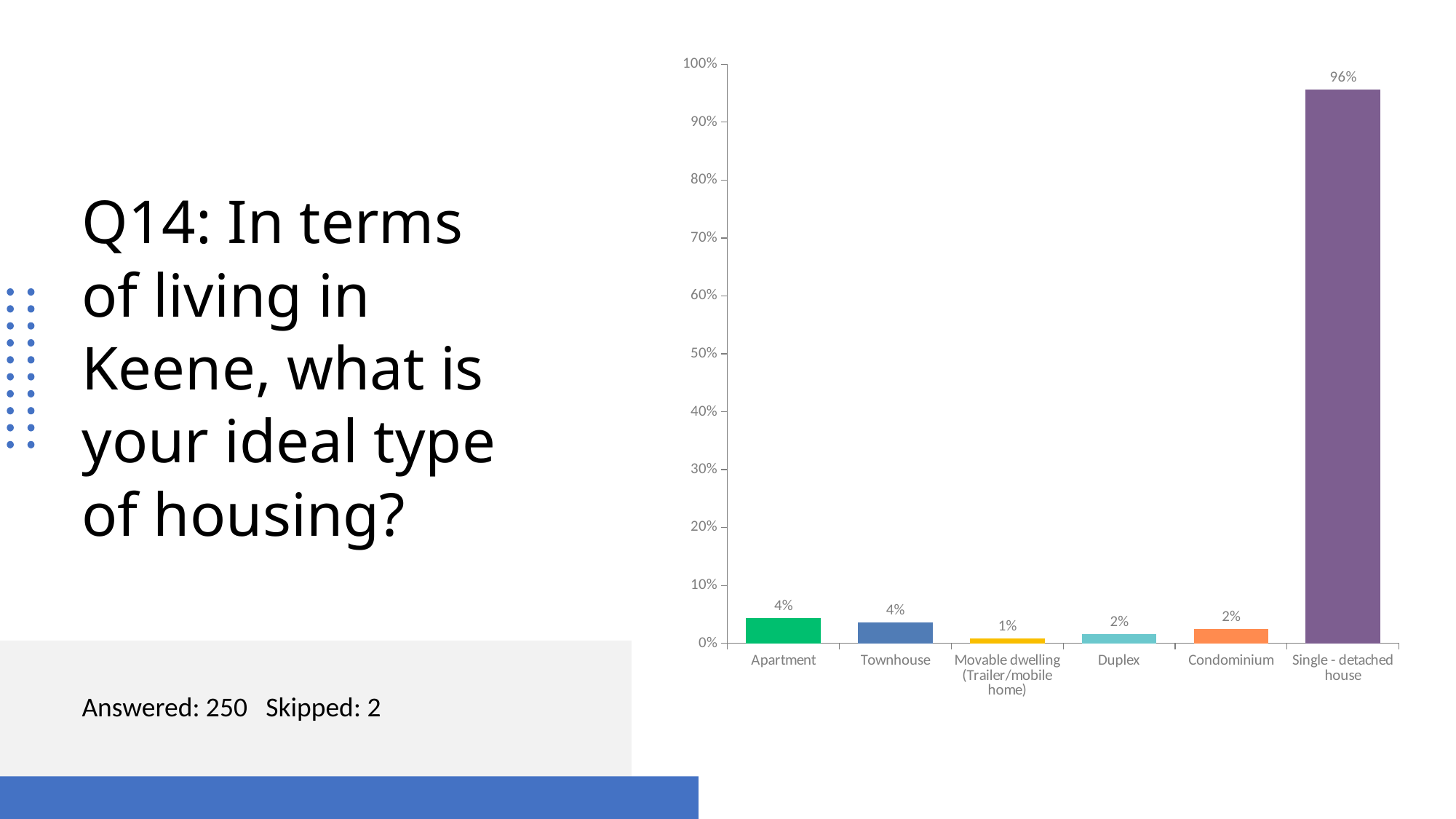
Which housing type has the lowest value in the chart? Movable dwelling (Trailer/mobile home) What is the value shown for Movable dwelling (Trailer/mobile home)? 1% Which housing type has the highest value in the chart? Single - detached house What colour is the bar for Single - detached house? Purple What is the difference between the values for Single - detached house and Townhouse? 92% Which is larger, the value for Duplex or the value for Single - detached house? Single - detached house What is the value shown for Apartment? 4% What is the value shown for Condominium? 2% How many housing type categories are shown on the x axis? 6 Is the value for Single - detached house greater or less than 90%? greater What percentage of respondents chose Single - detached house as their ideal type of housing? 96% What kind of chart is shown on the slide? Bar chart